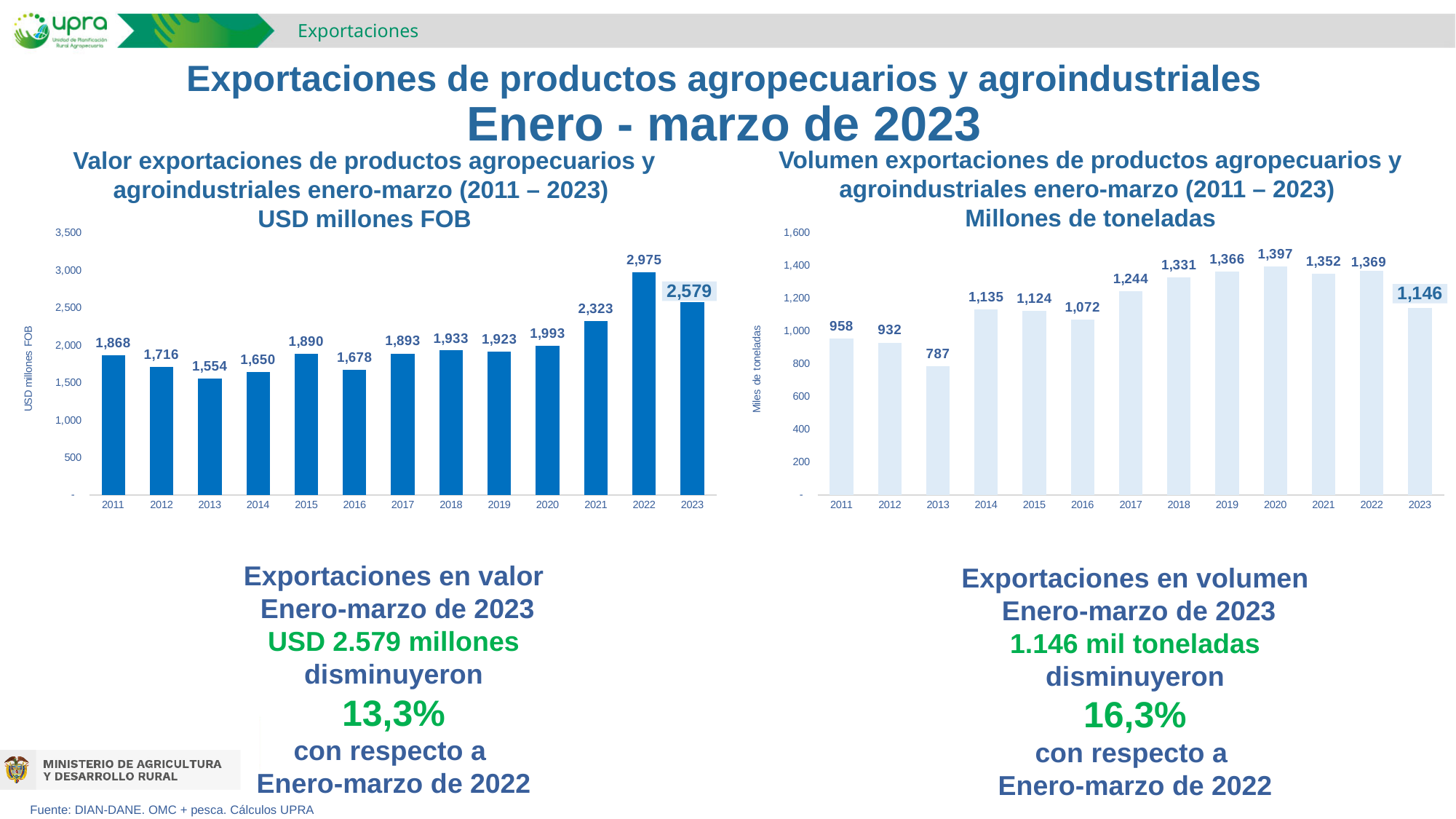
In the left chart (Valor exportaciones, USD millones FOB), which year has the highest value? 2022 In the right chart (Volumen exportaciones, Millones de toneladas), what is the difference between the 2022 and 2023 values? 223 In the right chart (Volumen exportaciones, Millones de toneladas), what is the value for 2020? 1,397 In the right chart (Volumen exportaciones, Millones de toneladas), which is larger, the value for 2014 or the value for 2016? 2014 What type of chart is the right chart (Volumen exportaciones, Millones de toneladas)? Bar chart In the left chart (Valor exportaciones, USD millones FOB), what is the value for 2013? 1,554 In the left chart (Valor exportaciones, USD millones FOB), what is the value for 2022? 2,975 In the left chart (Valor exportaciones, USD millones FOB), which year has the lowest value? 2013 In the right chart (Volumen exportaciones, Millones de toneladas), which year has the lowest value? 2013 In the left chart (Valor exportaciones, USD millones FOB), what is the difference between the 2022 and 2023 values? 396 In the left chart (Valor exportaciones, USD millones FOB), how many years are plotted? 13 In the right chart (Volumen exportaciones, Millones de toneladas), what is the value for 2023? 1,146